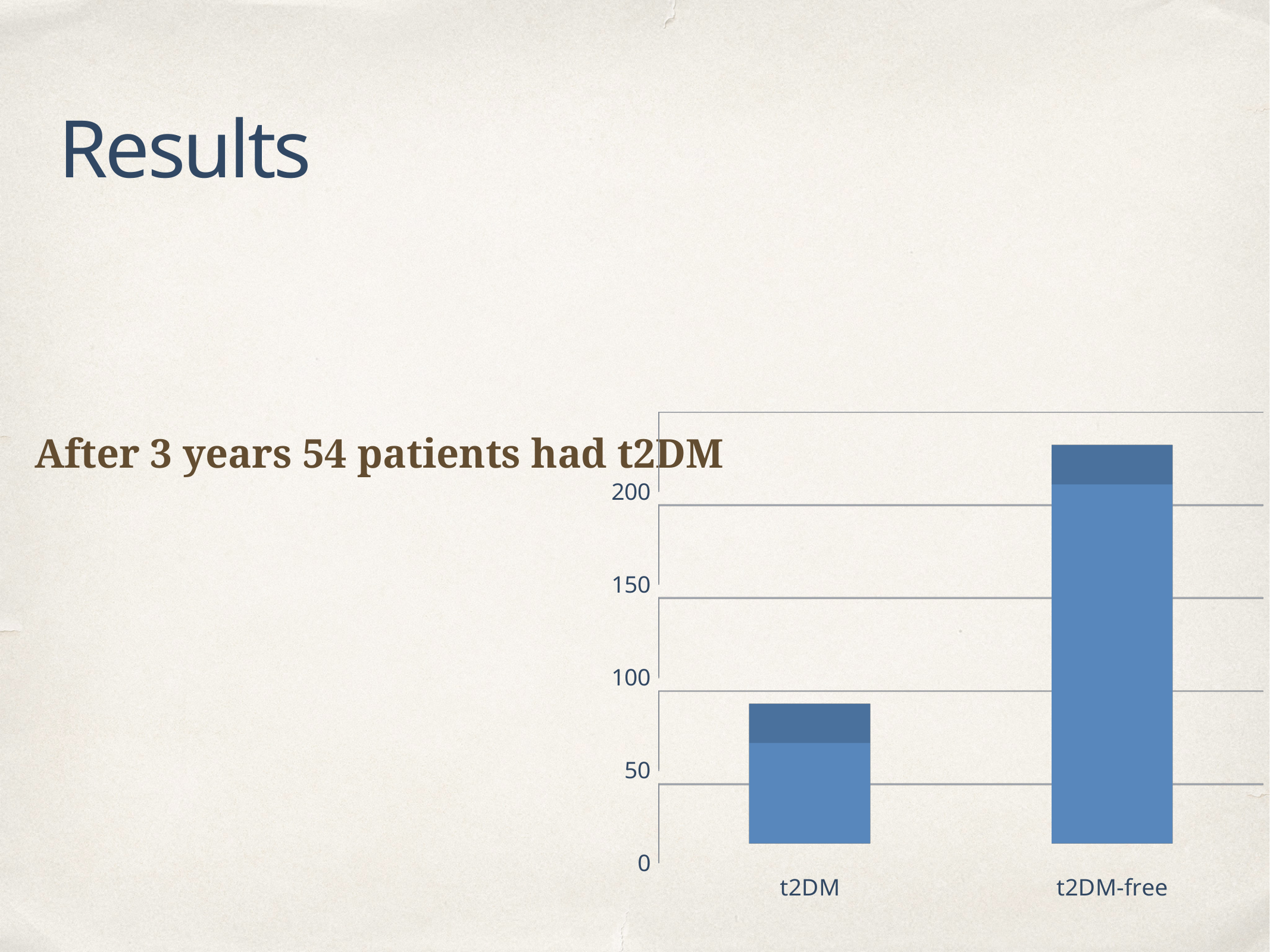
What are the two category labels on the x axis of the chart? t2DM and t2DM-free Which category has the lowest bar in the chart? t2DM Is the value for t2DM-free greater or less than 150? greater Is the value for t2DM greater or less than 50? greater Do the bar values rise or fall from t2DM to t2DM-free along the x axis? rise What is the highest tick value labelled on the chart's vertical axis? 200 Which bar is taller, t2DM or t2DM-free? t2DM-free Is the value for t2DM greater or less than 100? less Which category has the highest bar in the chart? t2DM-free How many categories are plotted in the bar chart? 2 What kind of chart is shown on the slide? bar chart